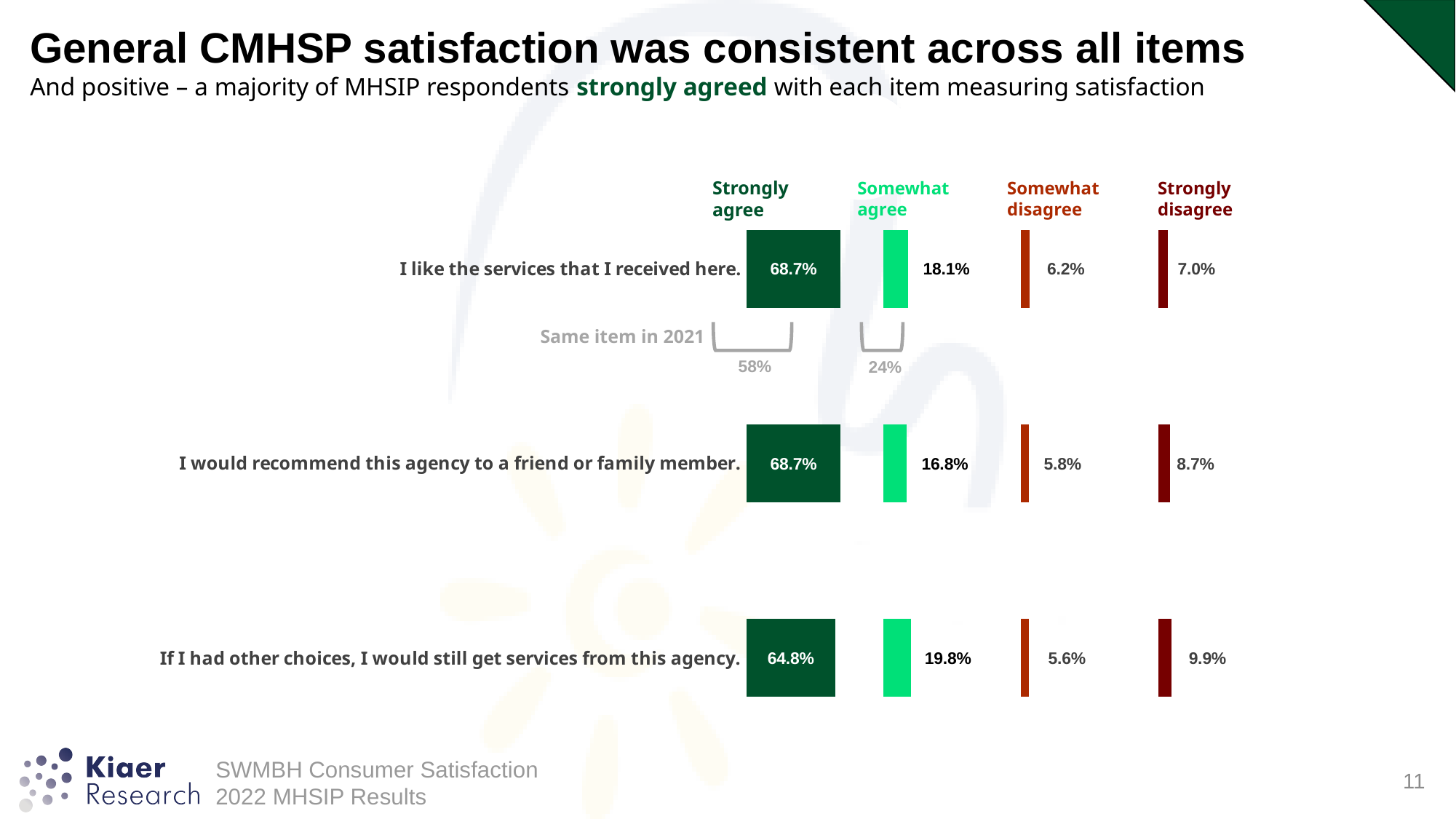
Which is larger: the "Somewhat disagree" percentage for "I like the services that I received here." or for "If I had other choices, I would still get services from this agency."? I like the services that I received here. What kind of chart is shown on the slide? Bar chart What was the "Strongly agree" percentage for "I like the services that I received here." in 2021? 58% Which item has the lowest "Strongly agree" percentage? If I had other choices, I would still get services from this agency. How many survey items are shown in the chart? 3 How many response categories does the chart show? 4 What percentage of respondents strongly agreed with "I like the services that I received here."? 68.7% What is the difference between the "Somewhat agree" percentages for "I like the services that I received here." and "I would recommend this agency to a friend or family member."? 1.3% What percentage of respondents somewhat agreed with "If I had other choices, I would still get services from this agency."? 19.8% What percentage of respondents strongly disagreed with "I would recommend this agency to a friend or family member."? 8.7% By how many percentage points did "Strongly agree" for "I like the services that I received here." change from 2021 (58%) to 68.7%? 10.7 percentage points Which item has the highest "Strongly disagree" percentage? If I had other choices, I would still get services from this agency.